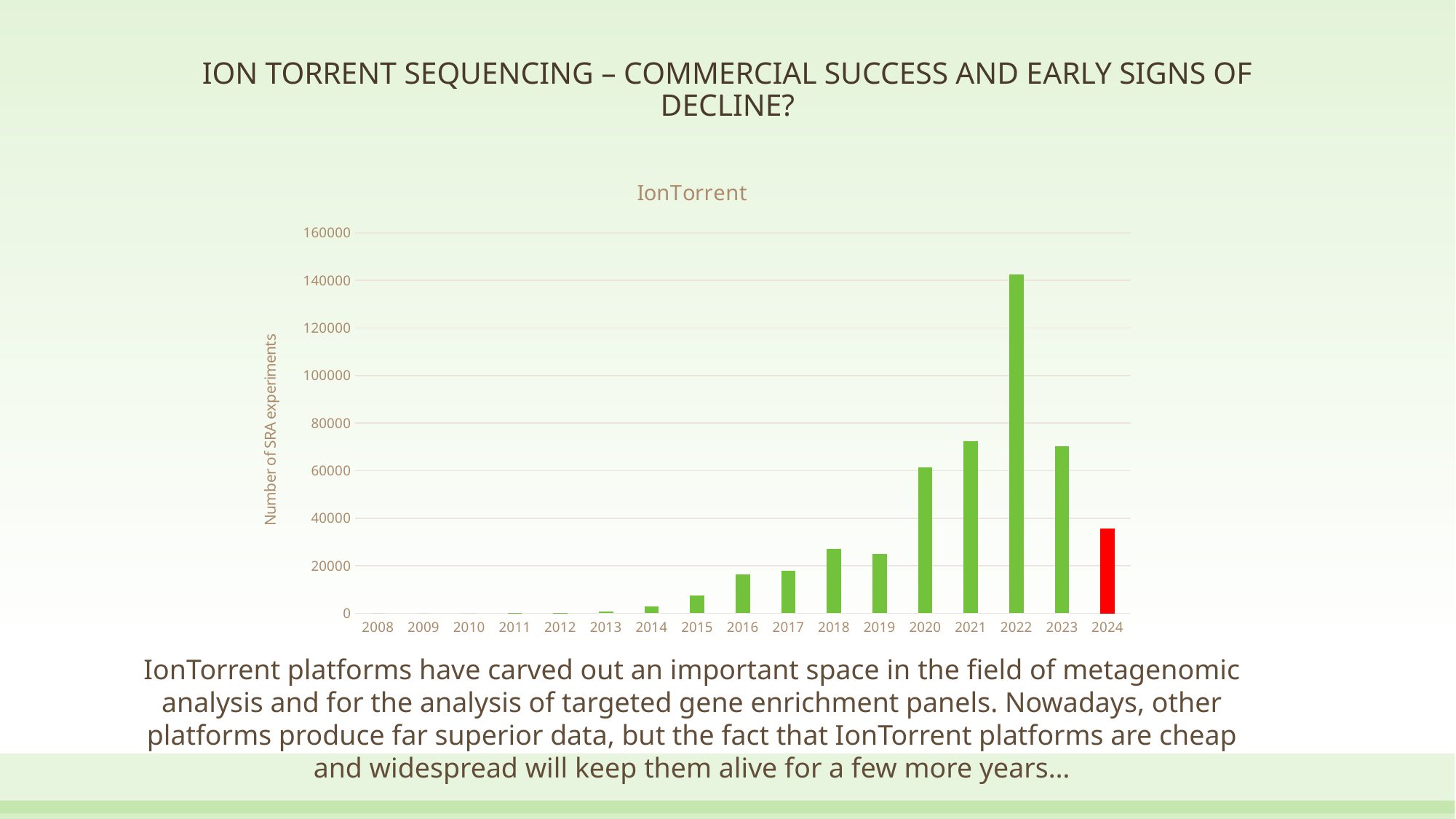
What is the label of the vertical axis? Number of SRA experiments How many years are shown on the x axis of the chart? 17 Which year has the highest number of SRA experiments? 2022 Is the value for 2024 greater or less than 40000? less Which is larger, the value for 2023 or the value for 2024? 2023 What kind of chart is shown on the slide? bar chart Is the value for 2020 greater or less than 40000? greater Is the value for 2022 greater or less than 120000? greater Which is larger, the value for 2022 or the value for 2021? 2022 What is the title of the chart? IonTorrent Do the values rise or fall from 2014 to 2022? rise